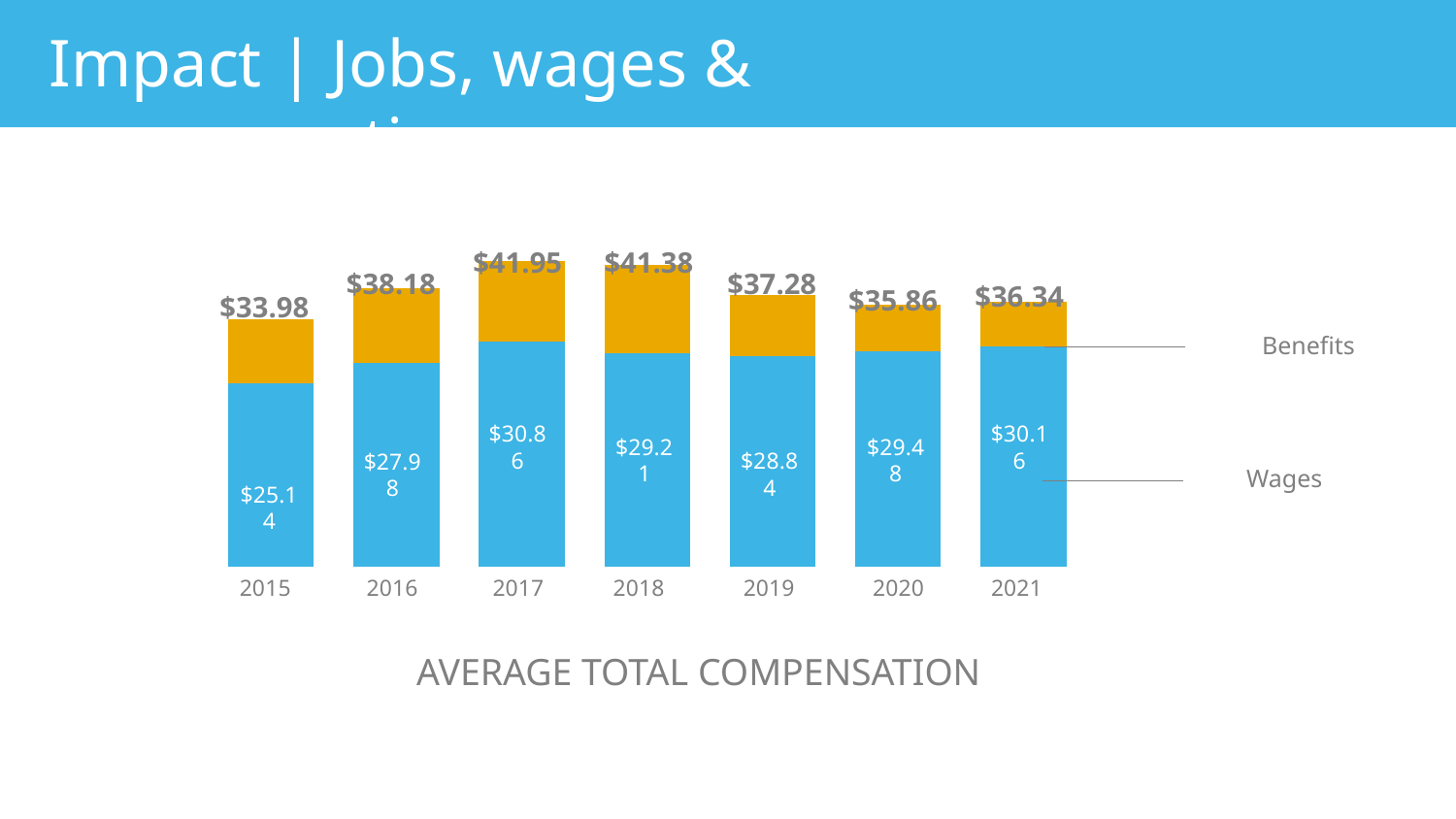
How many series does the chart show? 2 What is the wages value for 2015? $25.14 Which year has the lowest average total compensation? 2015 What is the wages value for 2021? $30.16 Which is larger, the wages value for 2018 or for 2020? 2020 Which year has the highest average total compensation? 2017 How many years are shown on the x axis? 7 What type of chart is shown on the slide? Stacked bar chart Which year has the lowest wages value? 2015 Which series is shown in orange? Benefits What is the average total compensation for 2017? $41.95 What is the difference in average total compensation between 2017 and 2015? $7.97